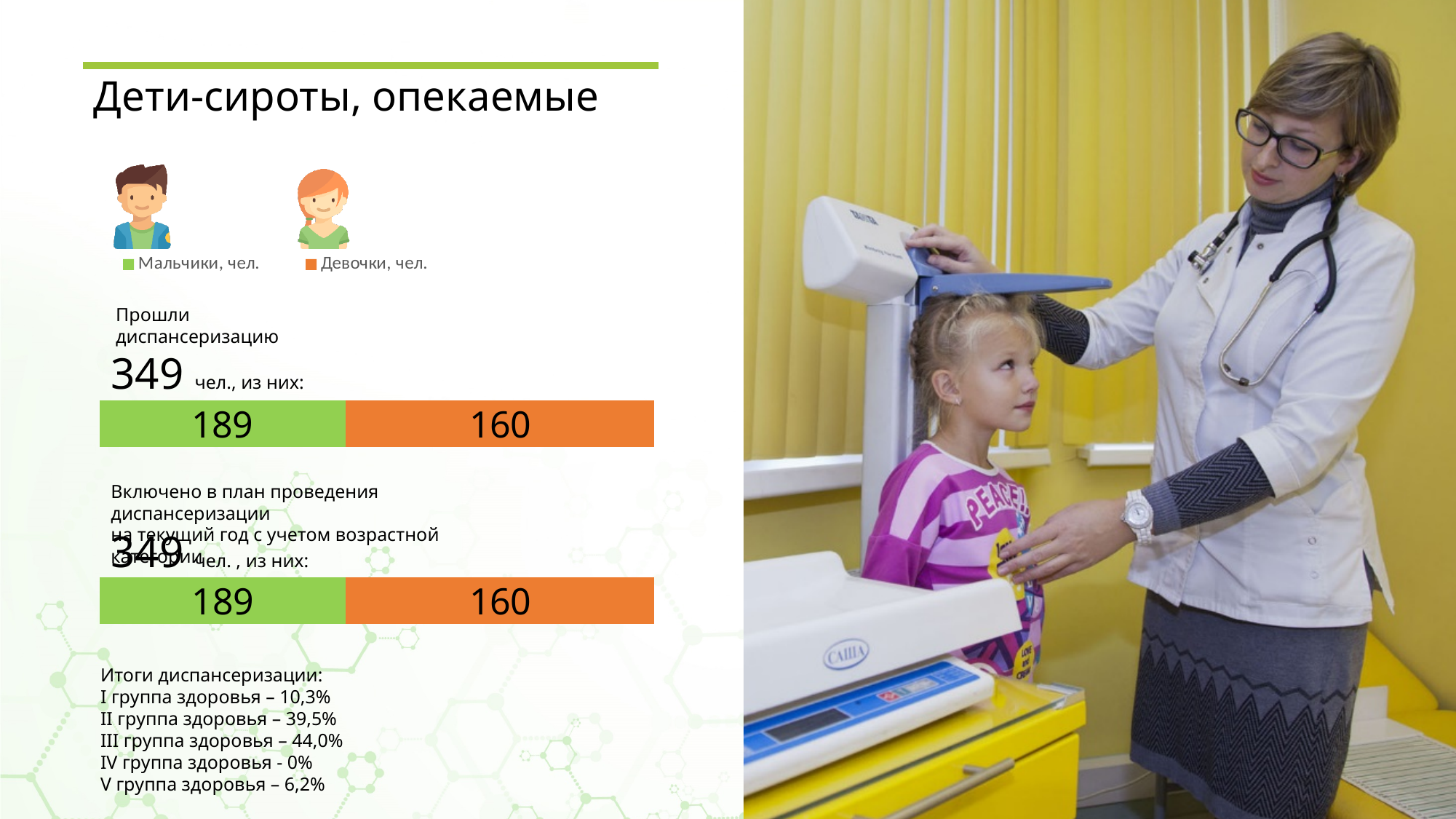
In the upper chart (Прошли диспансеризацию), which series has the larger value, Мальчики or Девочки? Мальчики In the lower chart (Включено в план проведения диспансеризации), what is the total of the stacked bar? 349 In the upper chart (Прошли диспансеризацию), what is the value for Мальчики, чел.? 189 In the charts on this slide, which colour represents Девочки, чел.? Orange In the lower chart (Включено в план проведения диспансеризации), what is the value for Мальчики, чел.? 189 In the lower chart (Включено в план проведения диспансеризации), which series has the smaller value? Девочки, чел. In the lower chart (Включено в план проведения диспансеризации), what is the value for Девочки, чел.? 160 In the upper chart (Прошли диспансеризацию), what is the difference between the values for Мальчики and Девочки? 29 How many series does the legend list for the charts on this slide? 2 In the upper chart (Прошли диспансеризацию), what is the value for Девочки, чел.? 160 In the upper chart (Прошли диспансеризацию), what is the total of the stacked bar? 349 What kind of chart is used in the upper chart (Прошли диспансеризацию)? Stacked bar chart